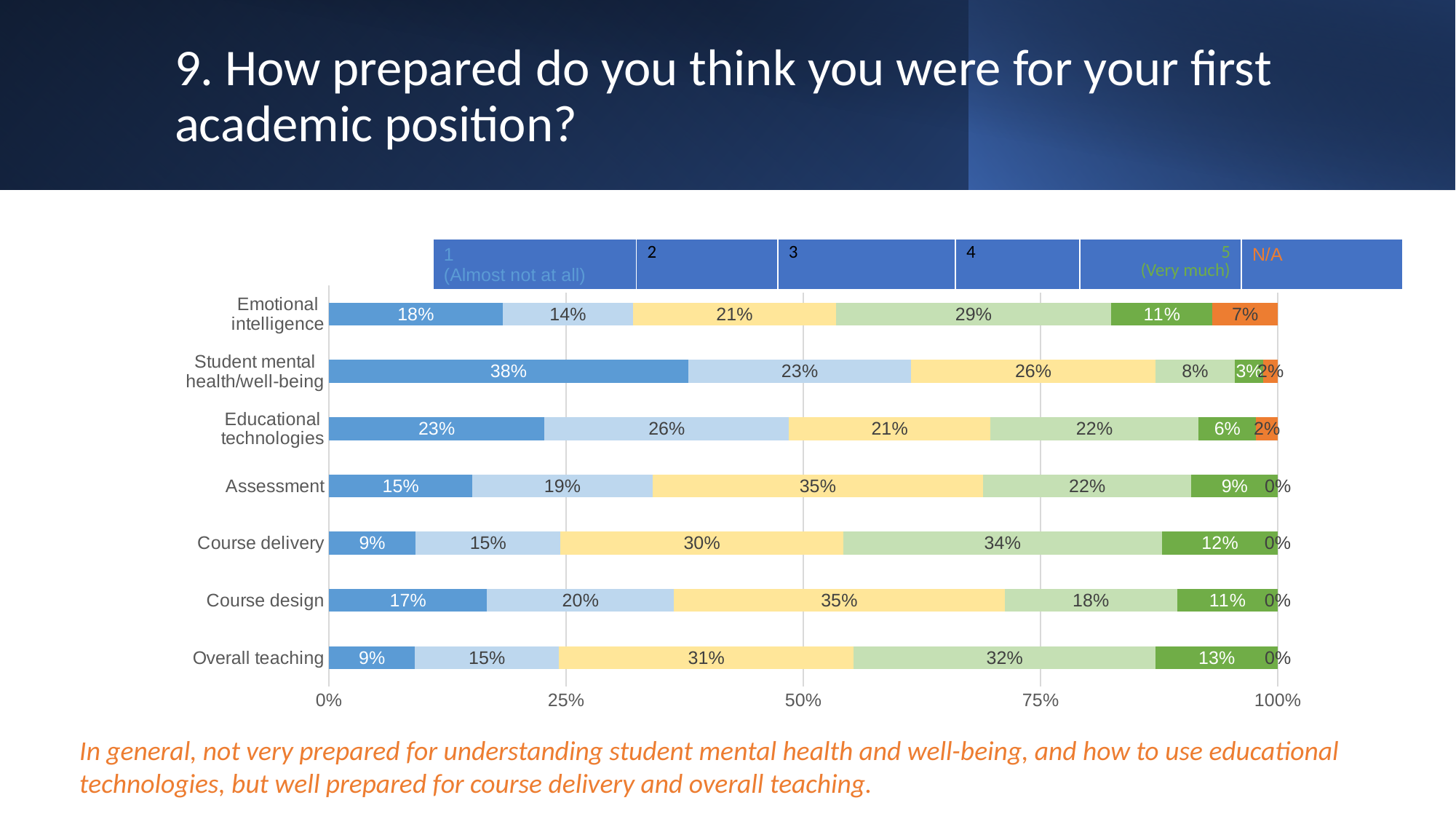
What is the N/A percentage for Emotional intelligence? 7% What percentage of respondents rated their preparation for Student mental health/well-being as 1 (Almost not at all)? 38% How many series does the legend list? 6 Which category has the highest percentage of rating 4 responses? Course delivery What is the difference in percentage points between the rating 4 share for Course delivery and for Emotional intelligence? 5 percentage points Which has a larger rating 3 share: Assessment or Course delivery? Assessment What percentage of respondents rated their preparation for Overall teaching as 5 (Very much)? 13% What colour represents the N/A series in the chart? Orange Which category has the lowest percentage of 5 (Very much) responses? Student mental health/well-being Which category has the highest percentage of 1 (Almost not at all) responses? Student mental health/well-being What type of chart is shown on the slide? Stacked bar chart How many categories are shown on the chart? 7